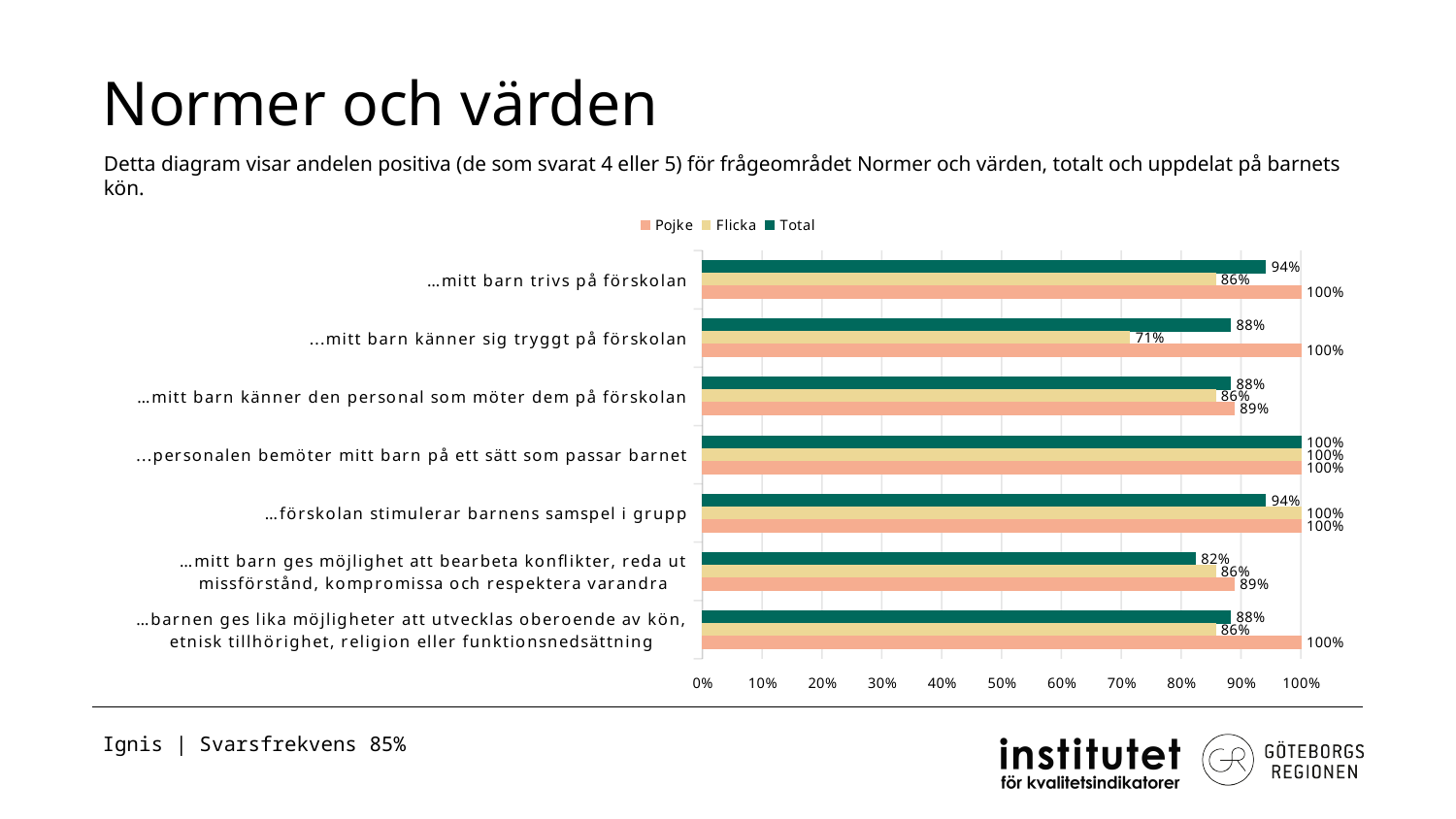
What is the Pojke value for "…mitt barn ges möjlighet att bearbeta konflikter, reda ut missförstånd, kompromissa och respektera varandra"? 89% What is the Flicka value for "…mitt barn känner sig tryggt på förskolan"? 71% Which category has the lowest Flicka value? …mitt barn känner sig tryggt på förskolan What is the Total value for "…personalen bemöter mitt barn på ett sätt som passar barnet"? 100% Which category has the lowest Total value? …mitt barn ges möjlighet att bearbeta konflikter, reda ut missförstånd, kompromissa och respektera varandra What is the Total value for "…mitt barn trivs på förskolan"? 94% What is the difference between the Pojke and Flicka values for "…mitt barn känner sig tryggt på förskolan"? 29% How many categories are shown on the chart? 7 What kind of chart is shown on the slide? Bar chart Which series is shown in dark green in the legend? Total For "…förskolan stimulerar barnens samspel i grupp", which is larger, the Flicka value or the Total value? Flicka How many series does the legend list? 3